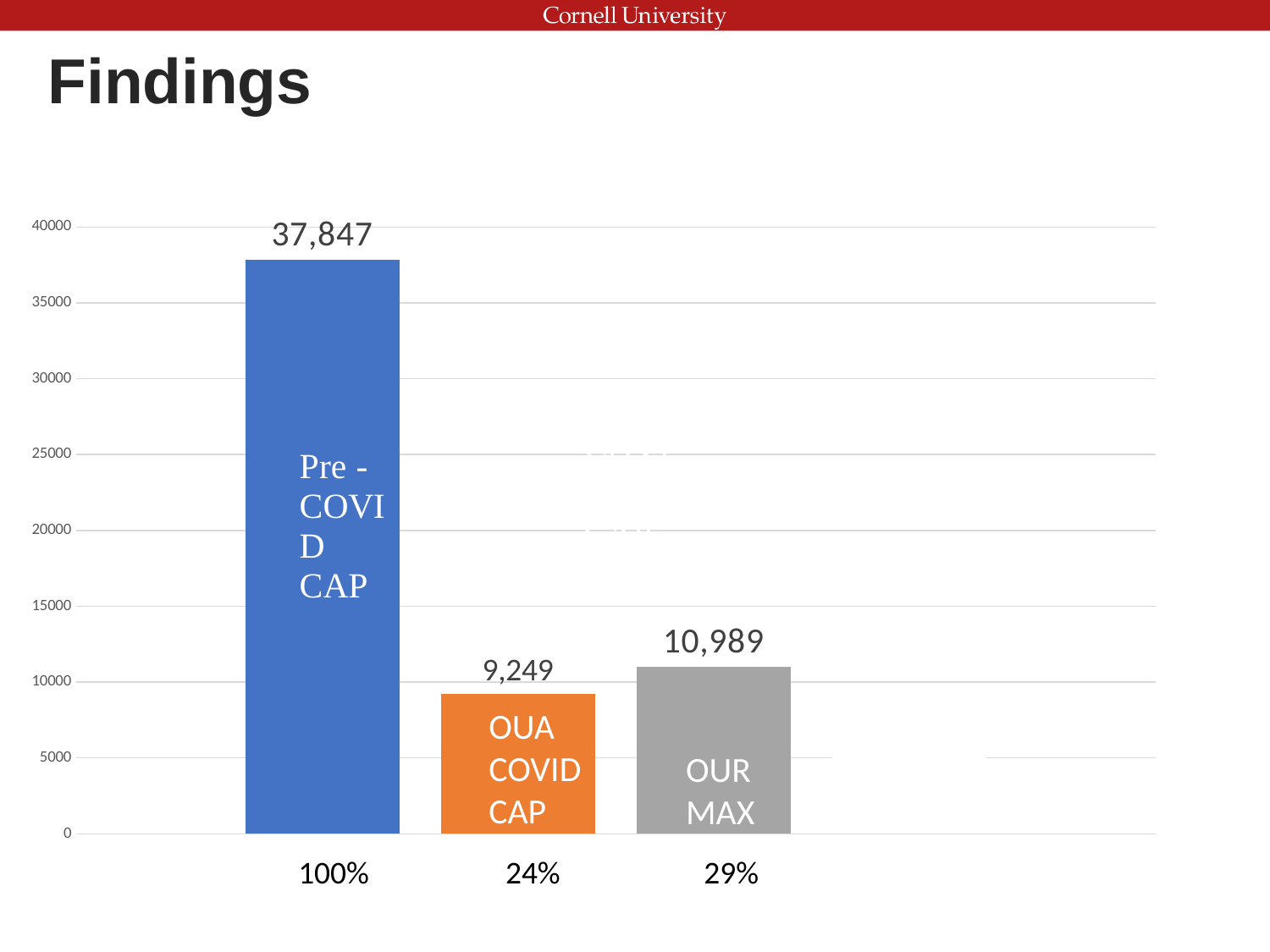
What percentage label appears below the OUR MAX bar? 29% What is the difference between the OUR MAX value and the OUA COVID CAP value? 1,740 What kind of chart is shown on the slide? bar chart What is the difference between the Pre-COVID CAP value and the OUR MAX value? 26,858 How many bars are shown in the chart? 3 What is the value shown for the OUR MAX bar? 10,989 Which bar has the highest value? Pre-COVID CAP Which bar has the lowest value? OUA COVID CAP Which is larger, the OUR MAX bar or the OUA COVID CAP bar? OUR MAX Is the value for OUA COVID CAP greater or less than 10000? less What is the value shown for the OUA COVID CAP bar? 9,249 What is the value shown for the Pre-COVID CAP bar? 37,847